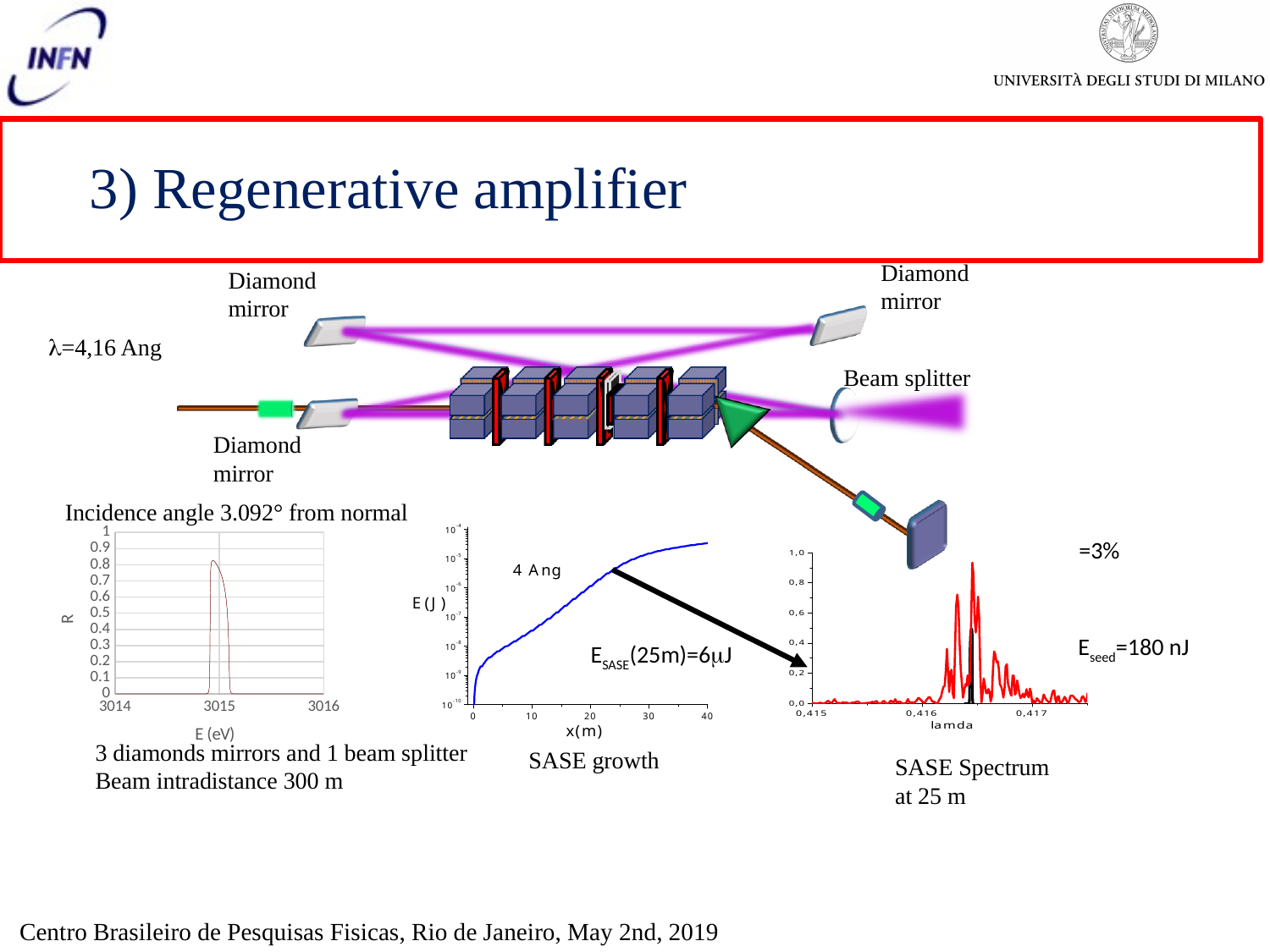
What kind of chart is the left chart with R on the vertical axis? line chart In the left chart (R vs E (eV)), is the value of R at 3014 eV greater or less than 0.1? less What kind of chart is the 'SASE Spectrum at 25 m' chart? line chart In the 'SASE Spectrum at 25 m' chart, is the peak value greater or less than 0,8? greater In the left chart (R vs E (eV)), is the peak value of R greater or less than 0.5? greater How many charts are shown on the slide? 3 In the 'SASE growth' chart, what is the label of the horizontal axis? x(m) What kind of chart is the 'SASE growth' chart? line chart In the left chart (R vs E (eV)), what is the label of the horizontal axis? E (eV) In the 'SASE growth' chart, does the energy E(J) rise or fall as x(m) increases? rise In the 'SASE growth' chart, what value of E_SASE at 25 m is given by the annotation? 6μJ In the left chart (R vs E (eV)), what is the highest tick value shown on the vertical axis? 1